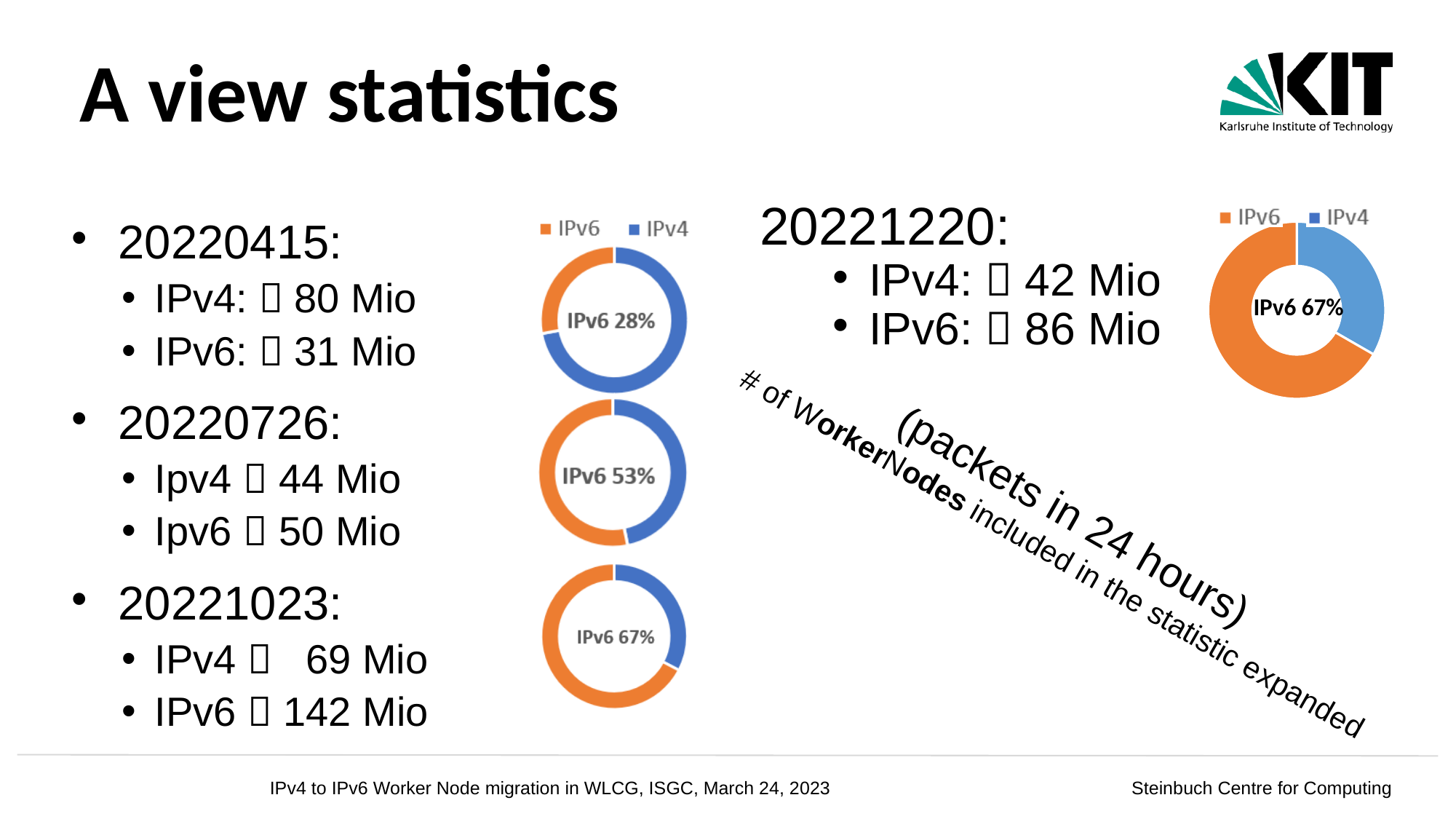
How many entries does the legend of the top doughnut chart in the middle column list? 2 In the doughnut chart at the top right of the slide, which colour represents IPv4? blue In the top doughnut chart in the middle column, which slice is larger, IPv6 or IPv4? IPv4 In the bottom doughnut chart in the middle column, which slice is larger, IPv6 or IPv4? IPv6 In the top doughnut chart in the middle column, what share is labelled for IPv6? IPv6 28% In the doughnut chart at the top right of the slide, which colour represents IPv6? orange In the middle doughnut chart in the middle column, what share is labelled for IPv6? IPv6 53% In the doughnut chart at the top right of the slide, which slice is larger, IPv6 or IPv4? IPv6 In the bottom doughnut chart in the middle column, what share is labelled for IPv6? IPv6 67% How many doughnut charts are shown on the slide? 4 What kind of chart is the top chart in the middle column of the slide? doughnut chart